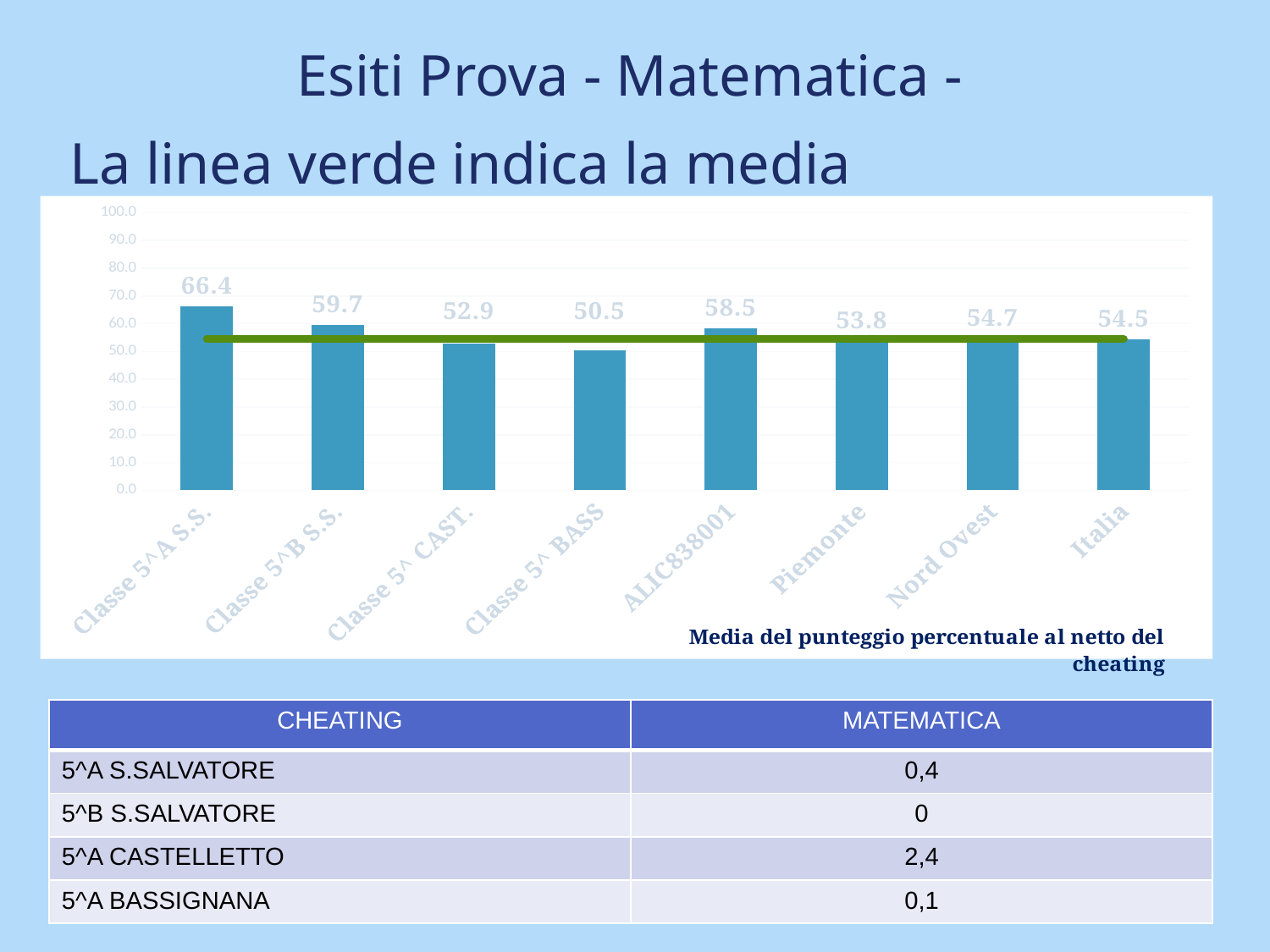
What does the green line on the chart indicate, according to the slide? la media What is the value for Classe 5^A S.S.? 66.4 Which category has the lowest value? Classe 5^ BASS How many categories are shown on the x axis? 8 What is the value for Italia? 54.5 What is the value for Piemonte? 53.8 Which is larger, the value for ALIC838001 or the value for Nord Ovest? ALIC838001 What is the legend entry shown below the chart? Media del punteggio percentuale al netto del cheating Which category has the highest value? Classe 5^A S.S. What is the difference between the values for Classe 5^A S.S. and Classe 5^B S.S.? 6.7 Is the value for Classe 5^ CAST. greater or less than 60.0? less What kind of chart is shown on the slide? combination bar and line chart